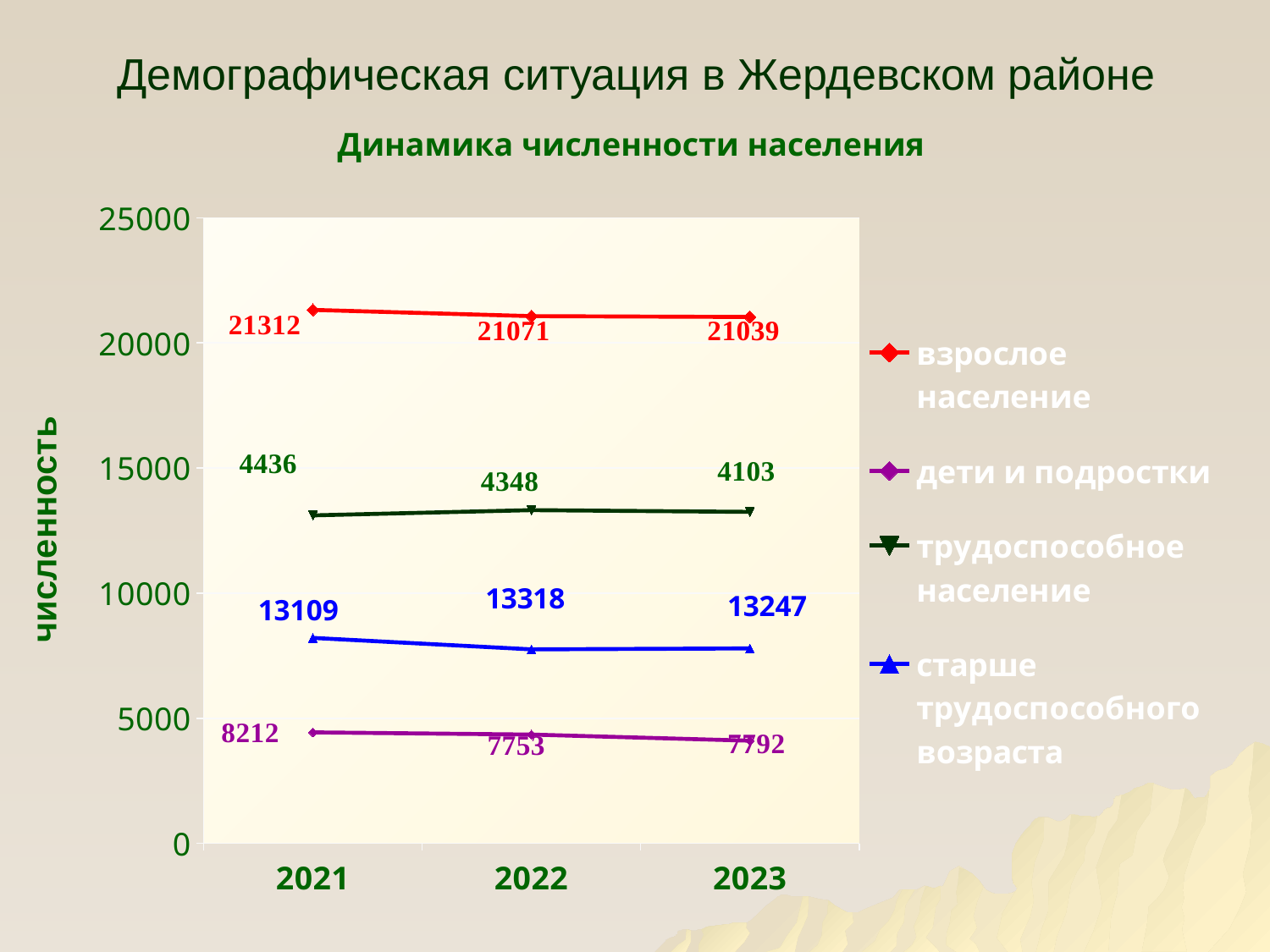
What is the value for взрослое население in 2022? 21071 How many series does the legend list? 4 Is the value for взрослое население in 2022 greater or less than 20000? greater What is the difference between взрослое население in 2021 and 2022? 241 Which series is plotted highest on the chart? взрослое население What is the value for взрослое население in 2023? 21039 What is the value for взрослое население in 2021? 21312 How many years are plotted along the x axis? 3 What kind of chart is shown on the slide? line chart Does the взрослое население series rise or fall from 2021 to 2023? fall By how much did взрослое население decrease from 2021 to 2023? 273 What is the title of the chart? Динамика численности населения